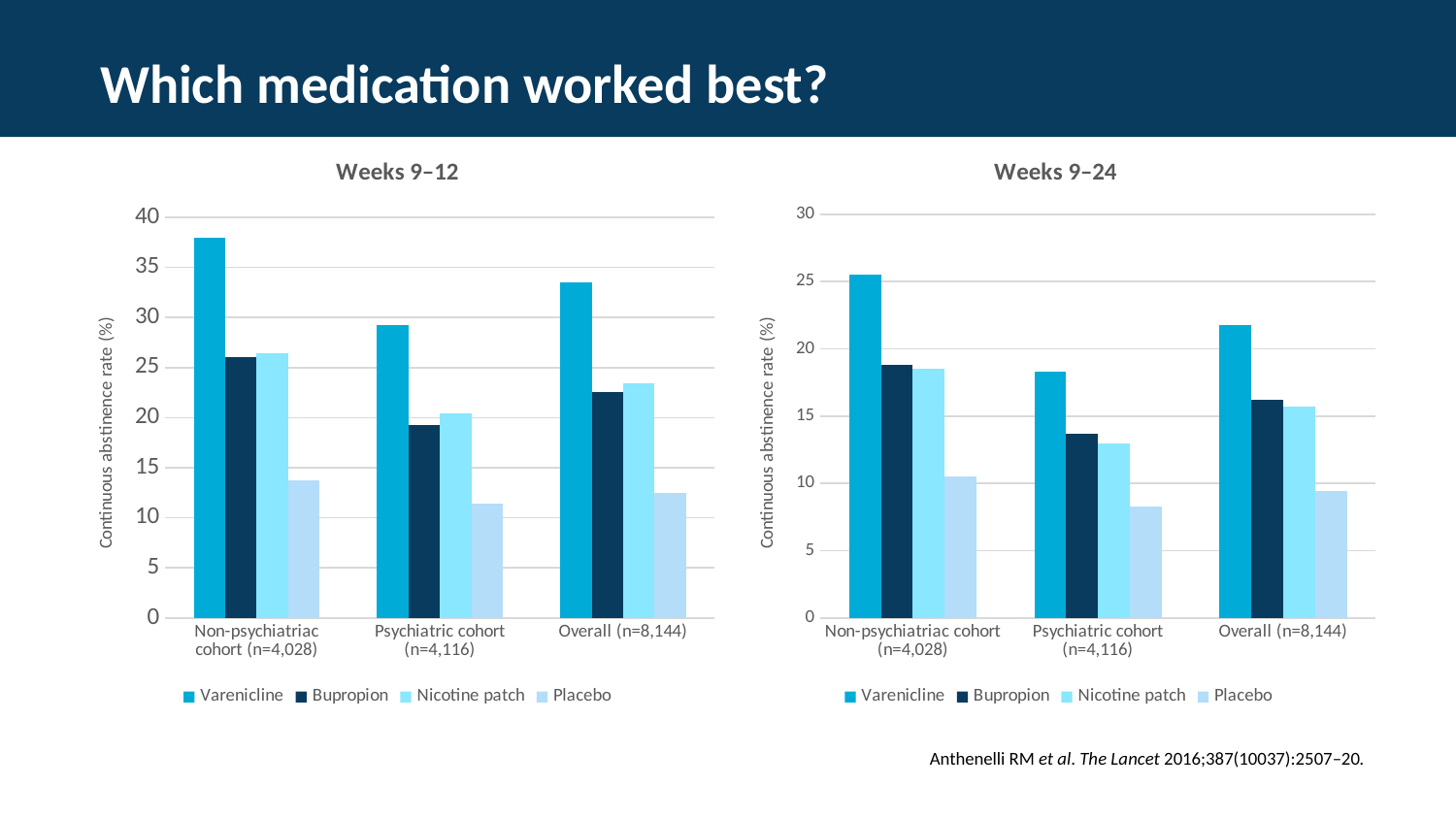
In the "Weeks 9–12" chart, which cohort has the higher Varenicline value: Non-psychiatric or Psychiatric? Non-psychiatric cohort In the "Weeks 9–12" chart, is the Placebo value for the Psychiatric cohort greater or less than 15? less In the "Weeks 9–24" chart, which is larger for the Overall group: Varenicline or Bupropion? Varenicline How many series does the legend of the "Weeks 9–24" chart list? 4 In the "Weeks 9–24" chart, is the Placebo value for the Psychiatric cohort greater or less than 10? less In the "Weeks 9–12" chart, is the Varenicline value for the Non-psychiatric cohort greater or less than 35? greater What is the y-axis label of the "Weeks 9–24" chart? Continuous abstinence rate (%) In the "Weeks 9–12" chart, which medication has the highest continuous abstinence rate in the Non-psychiatric cohort? Varenicline How many cohort categories are shown on the x axis of the "Weeks 9–12" chart? 3 In the "Weeks 9–12" chart, which medication has the lowest continuous abstinence rate in the Overall group? Placebo What kind of chart is the "Weeks 9–12" chart? bar chart